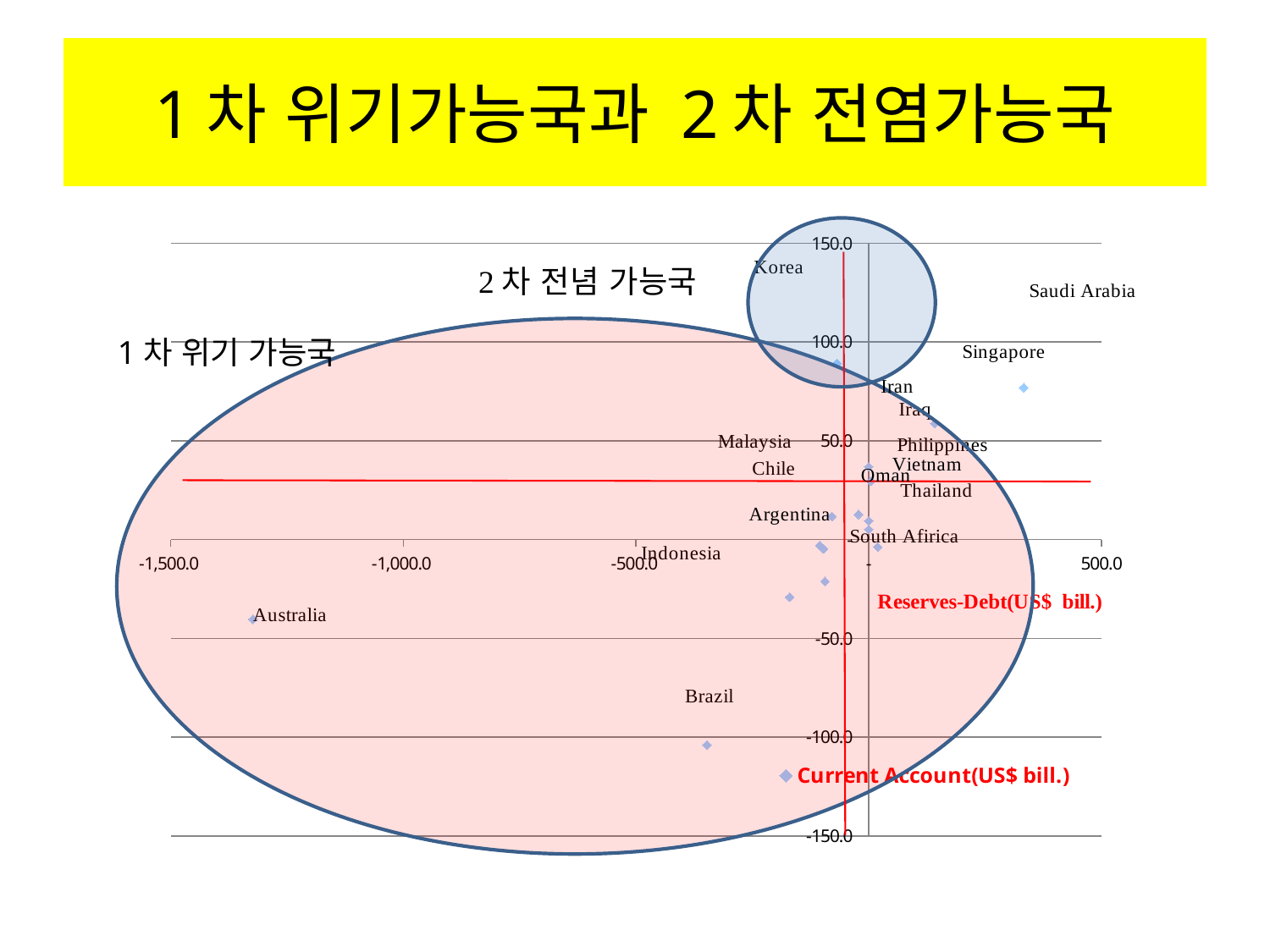
What is the label of the horizontal axis of the chart? Reserves-Debt(US$ bill.) Is the Reserves-Debt value for Australia greater or less than -1,000.0? less Which labelled country has the lowest Reserves-Debt value in the chart? Australia What kind of chart is shown on the slide? scatter chart What is the name of the series shown in the chart legend? Current Account(US$ bill.) Which labelled country has the lowest Current Account value in the chart? Brazil Which has the larger Current Account value, Korea or Brazil? Korea Is the Current Account value for Brazil greater or less than -50.0? less Which has the larger Reserves-Debt value, Australia or Brazil? Brazil How many series does the chart legend list? 1 Is the Current Account value for Korea greater or less than 50.0? greater